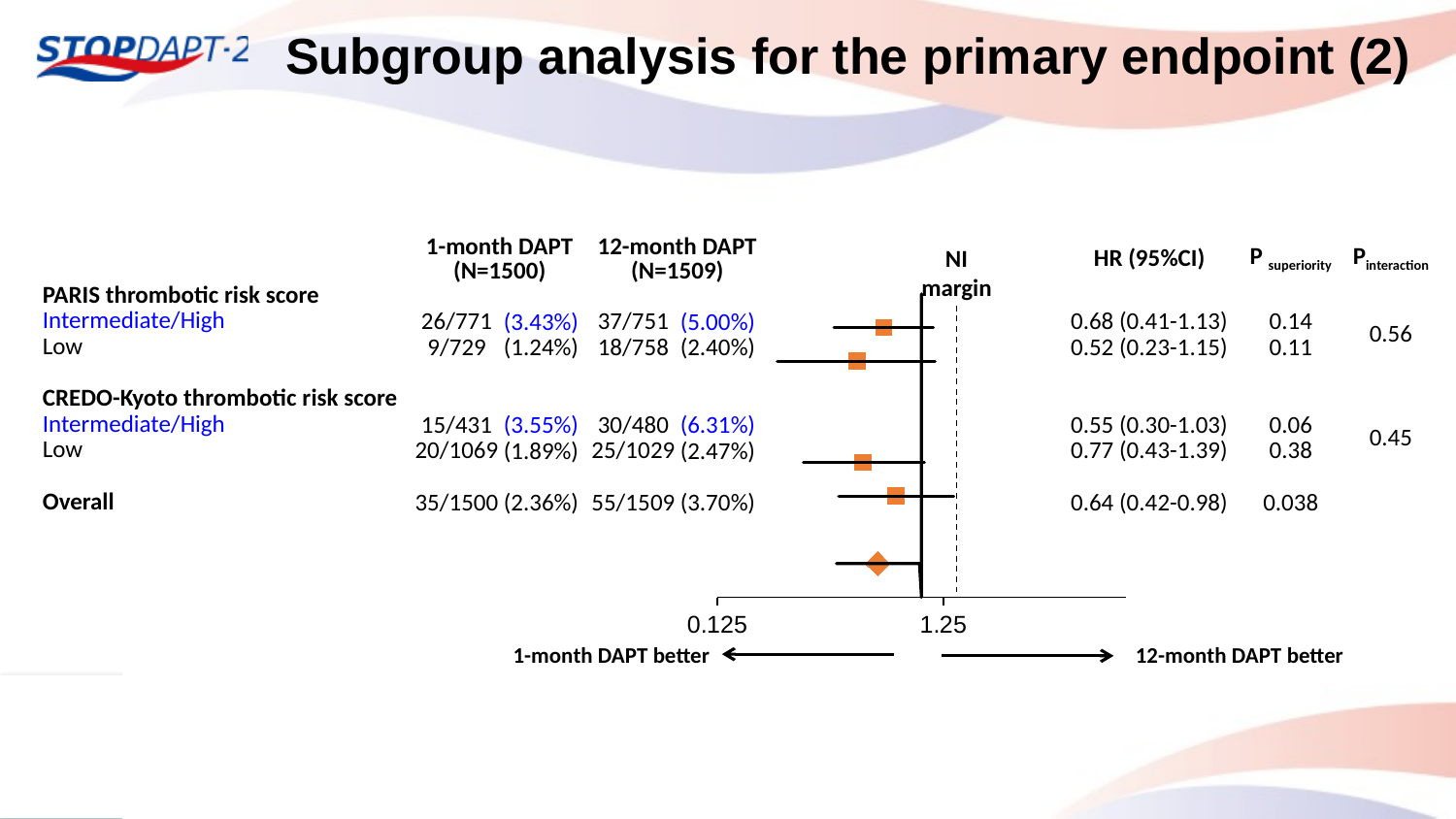
What is the 1-month DAPT event rate for the PARIS thrombotic risk score Low subgroup? 1.24% What is the P superiority value for the Overall row? 0.038 Is the hazard ratio for the CREDO-Kyoto Low subgroup greater or less than 1.25? less Which subgroup has the lowest hazard ratio point estimate? PARIS thrombotic risk score Low (0.52) Which subgroup has the highest hazard ratio point estimate? CREDO-Kyoto thrombotic risk score Low (0.77) What is the HR (95%CI) for the PARIS thrombotic risk score Intermediate/High subgroup? 0.68 (0.41-1.13) What is the P interaction value for the CREDO-Kyoto thrombotic risk score subgroups? 0.45 What is the difference between the 12-month DAPT and 1-month DAPT event rates in the Overall row? 1.34 percentage points What kind of chart is shown on the slide? Forest plot How many hazard ratio estimates are plotted in the forest plot, including the Overall estimate? 5 Which has the larger hazard ratio: the PARIS Intermediate/High subgroup or the CREDO-Kyoto Intermediate/High subgroup? PARIS Intermediate/High What does the dashed vertical line in the forest plot represent? NI margin